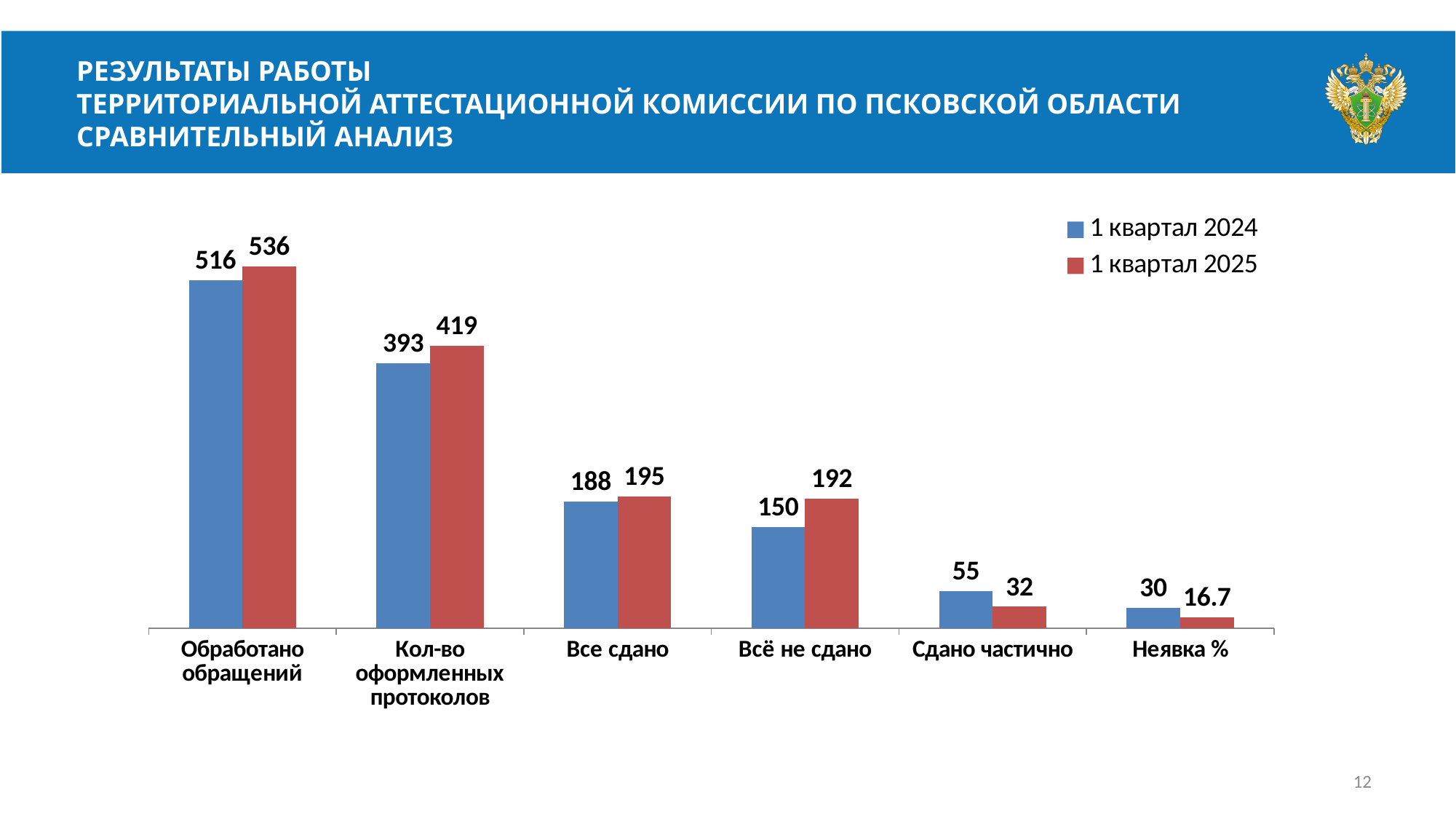
Which category has the highest value in the «1 квартал 2024» series? Обработано обращений What is the difference between the «1 квартал 2024» and «1 квартал 2025» values for «Сдано частично»? 23 What is the difference between the «1 квартал 2025» and «1 квартал 2024» values for «Кол-во оформленных протоколов»? 26 Which category has the lowest value in the «1 квартал 2025» series? Неявка % What is the value for «Всё не сдано» in the «1 квартал 2024» series? 150 How many series does the legend list? 2 What is the value for «Неявка %» in the «1 квартал 2025» series? 16.7 What kind of chart is shown on the slide? Bar chart How many categories are shown on the x axis of the chart? 6 For «Сдано частично», which series has the larger value: «1 квартал 2024» or «1 квартал 2025»? 1 квартал 2024 What is the value for «Обработано обращений» in the «1 квартал 2025» series? 536 For «Всё не сдано», which series has the larger value: «1 квартал 2024» or «1 квартал 2025»? 1 квартал 2025